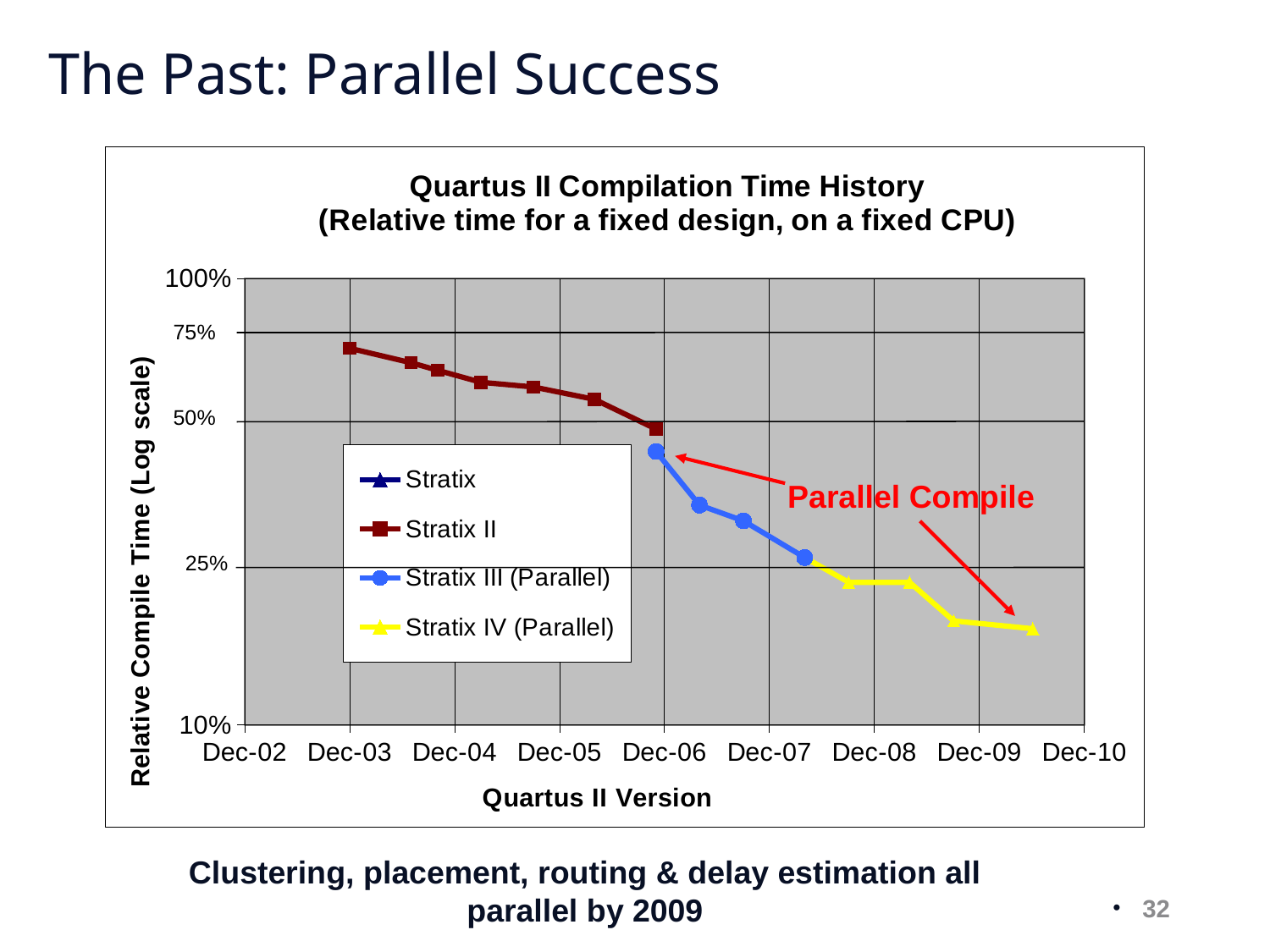
What is the label of the y axis? Relative Compile Time (Log scale) What is the title of the chart? Quartus II Compilation Time History (Relative time for a fixed design, on a fixed CPU) How many data points are plotted for the Stratix II series? 7 Is the first Stratix III (Parallel) value at Dec-06 greater or less than 50%? less Which is larger: the Stratix II value at Dec-03 or the last Stratix IV (Parallel) value? Stratix II value at Dec-03 Which series has the lowest relative compile time values on the chart? Stratix IV (Parallel) Do the relative compile time values rise or fall as the Quartus II version moves from Dec-03 to Dec-10? fall What kind of chart is shown on the slide? line chart Is the Stratix II value at Dec-03 greater or less than 75%? less Is the Stratix II value at Dec-03 greater or less than 50%? greater How many series does the chart legend list? 4